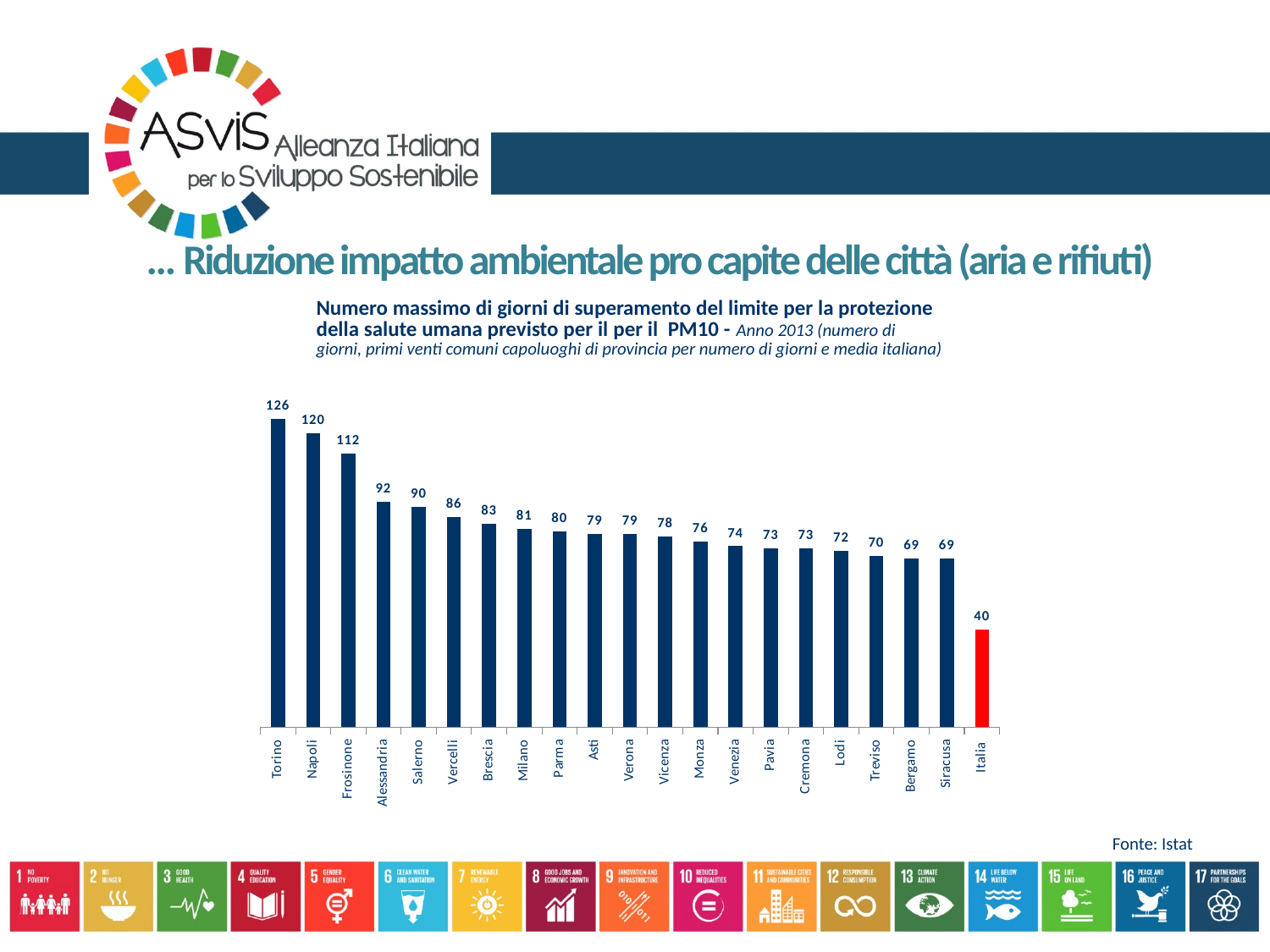
How many categories are shown on the x axis? 21 Which category has the highest value? Torino Which bar is coloured red? Italia What is the difference between the values for Torino and Italia? 86 Which is larger, the value for Alessandria or the value for Vercelli? Alessandria What is the value for Torino? 126 Do the values rise or fall from Torino to Siracusa along the x axis? Fall Which category has the lowest value? Italia What is the value for Milano? 81 What kind of chart is this? Bar chart What is the difference between the values for Napoli and Frosinone? 8 What is the value for Italia? 40